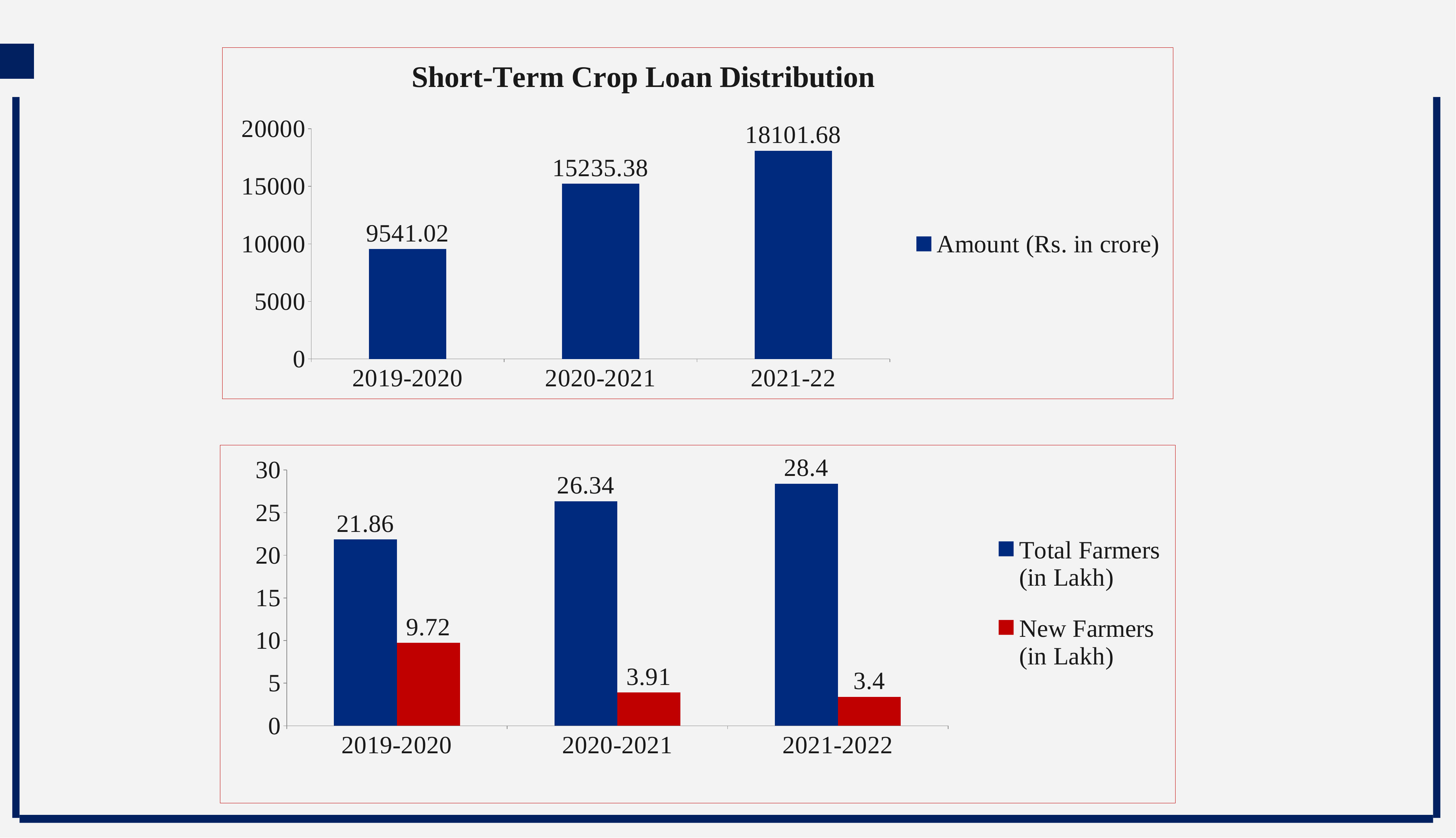
In the 'Short-Term Crop Loan Distribution' chart, how many years are shown on the x axis? 3 In the 'Short-Term Crop Loan Distribution' chart, what is the difference between the amounts for 2021-22 and 2019-2020? 8560.66 In the 'Short-Term Crop Loan Distribution' chart, what is the amount (Rs. in crore) for 2020-2021? 15235.38 In the 'Short-Term Crop Loan Distribution' chart, do the amounts rise or fall from 2019-2020 to 2021-22? rise In the bottom chart, what is the value of Total Farmers (in Lakh) for 2021-2022? 28.4 In the bottom chart, what is the difference between Total Farmers and New Farmers (in Lakh) for 2020-2021? 22.43 In the bottom chart, which year has the highest value for New Farmers (in Lakh)? 2019-2020 What kind of chart is the bottom chart? bar chart In the 'Short-Term Crop Loan Distribution' chart, which year has the lowest amount? 2019-2020 In the bottom chart, how many series does the legend list? 2 In the 'Short-Term Crop Loan Distribution' chart, which year has the highest amount? 2021-22 In the bottom chart, what is the value of New Farmers (in Lakh) for 2019-2020? 9.72